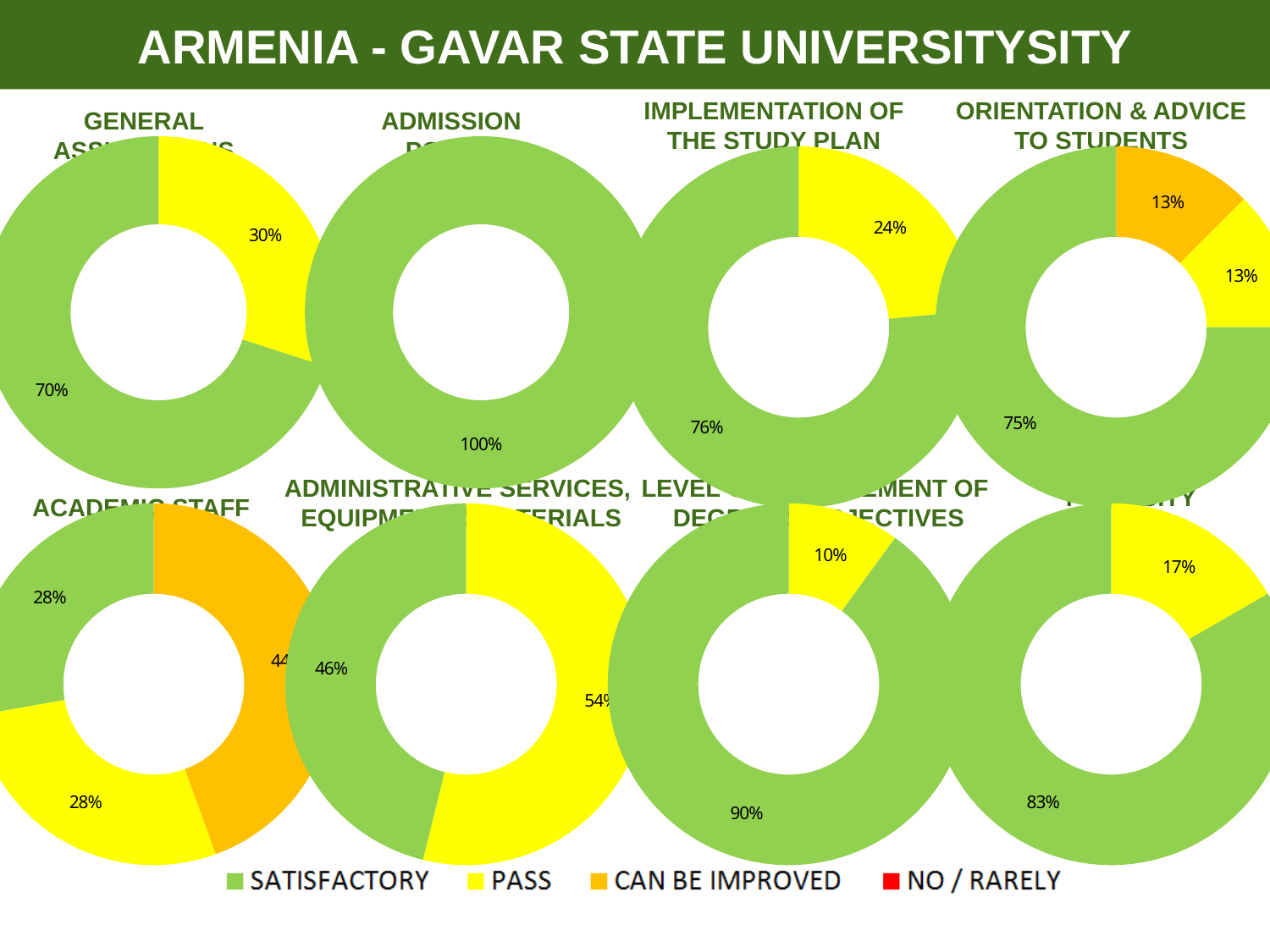
What kind of chart is used on this slide? Donut (pie) chart In the top-left chart (General), what is the difference between the Satisfactory and Pass shares? 40% In the second chart of the top row (Admission), what percentage is Satisfactory? 100% Which colour represents 'Pass' in the legend? Yellow In the 'Academic Staff' chart, which category has the largest share? Can Be Improved In the 'Implementation of the Study Plan' chart, which is larger, the Satisfactory share or the Pass share? Satisfactory In the 'Implementation of the Study Plan' chart, what percentage is labelled Pass (yellow)? 24% In the 'Orientation & Advice to Students' chart, what percentage is Satisfactory (green)? 75% How many entries does the legend list? 4 In the 'Orientation & Advice to Students' chart, what percentage is Can Be Improved (orange)? 13% In the 'Academic Staff' chart, what percentage is Can Be Improved (orange)? 44% In the 'Implementation of the Study Plan' chart, what percentage is labelled Satisfactory (green)? 76%